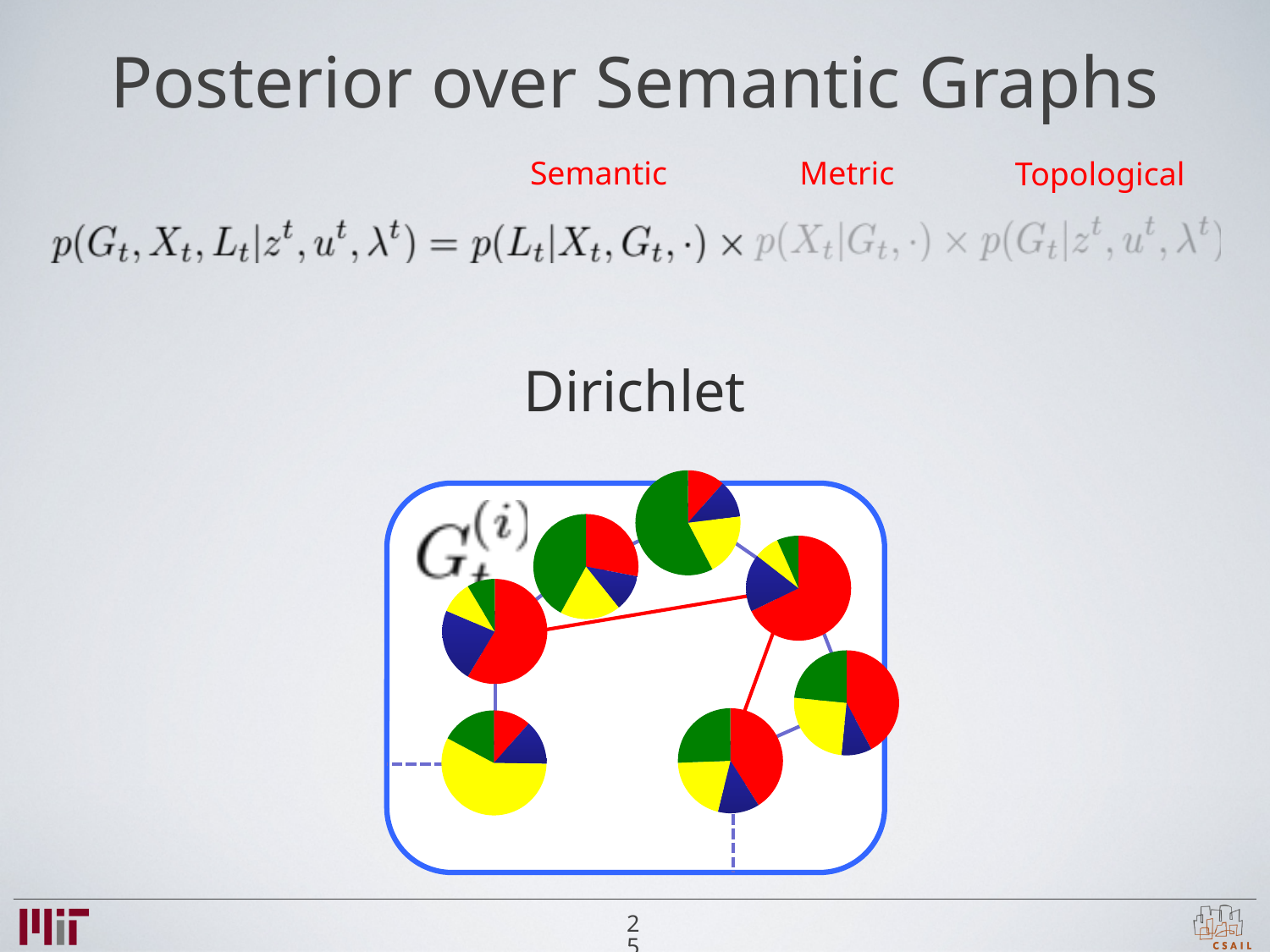
How many distinct colours are used in the pie-chart nodes on the slide? 4 In the pie-chart node on the right side of the graph (middle right), which colour takes the largest share? red What label is written in the top-left corner of the blue box containing the pie-chart nodes? G_t^(i) In the bottom-left pie-chart node, which colour takes the largest share? yellow In the bottom-left pie-chart node, is the yellow slice larger or smaller than half of the pie? larger What kind of charts are used as the nodes of the graph on the slide? pie charts How many pie-chart nodes are shown inside the blue box on the slide? 7